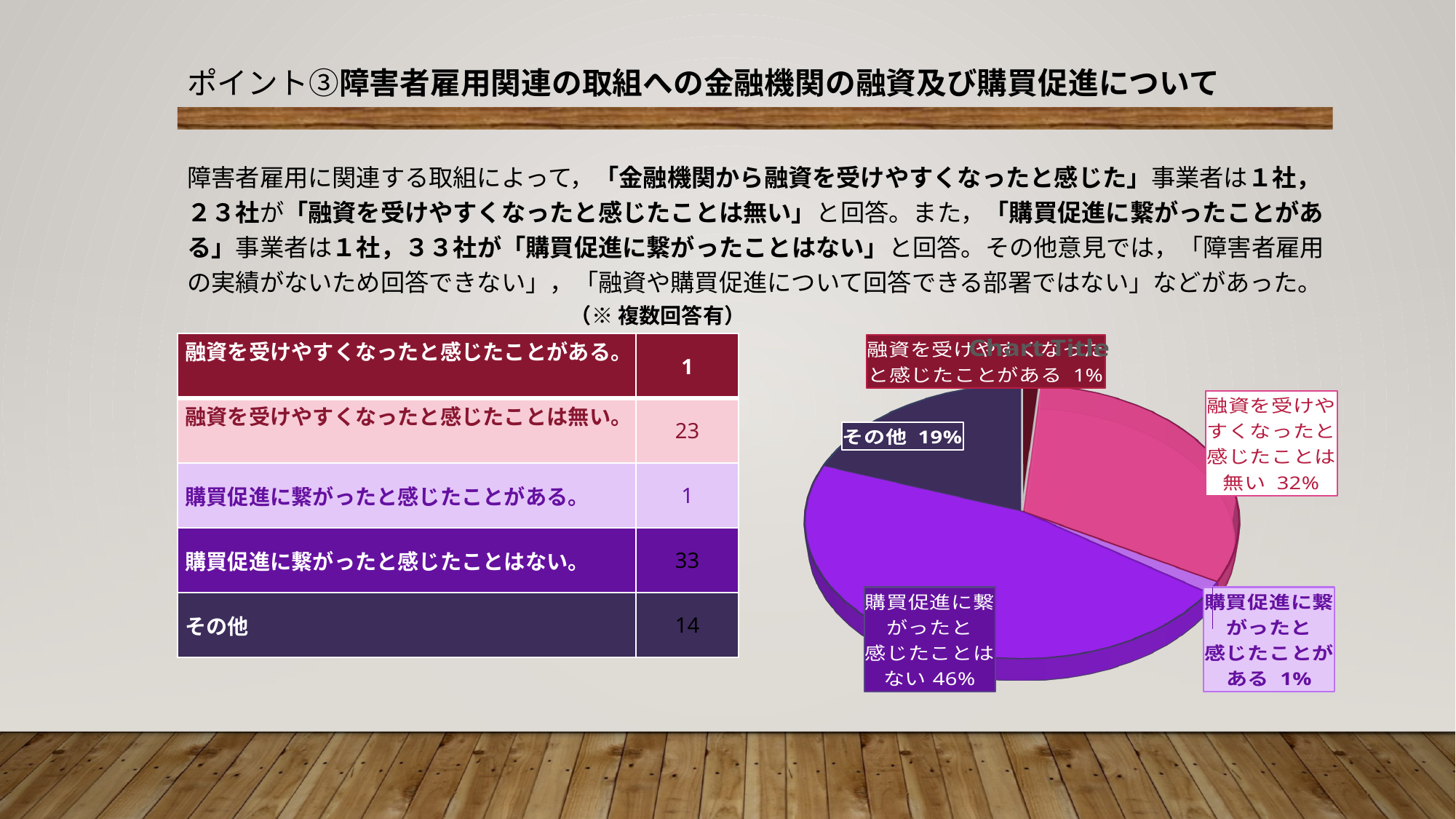
How many slices does the pie chart have? 5 Which category has the largest slice in the pie chart? 購買促進に繋がったと感じたことはない What kind of chart is shown on the slide? pie chart What is the difference in percentage points between 「融資を受けやすくなったと感じたことは無い」 and 「その他」 in the pie chart? 13 What share of the pie does 「購買促進に繋がったと感じたことがある」 represent? 1% What share of the pie does 「その他」 represent? 19% What title is displayed above the pie chart? Chart Title Which is larger in the pie chart: 「融資を受けやすくなったと感じたことは無い」 or 「その他」? 融資を受けやすくなったと感じたことは無い What share of the pie does 「融資を受けやすくなったと感じたことは無い」 represent? 32% What is the difference in percentage points between 「購買促進に繋がったと感じたことはない」 and 「融資を受けやすくなったと感じたことは無い」 in the pie chart? 14